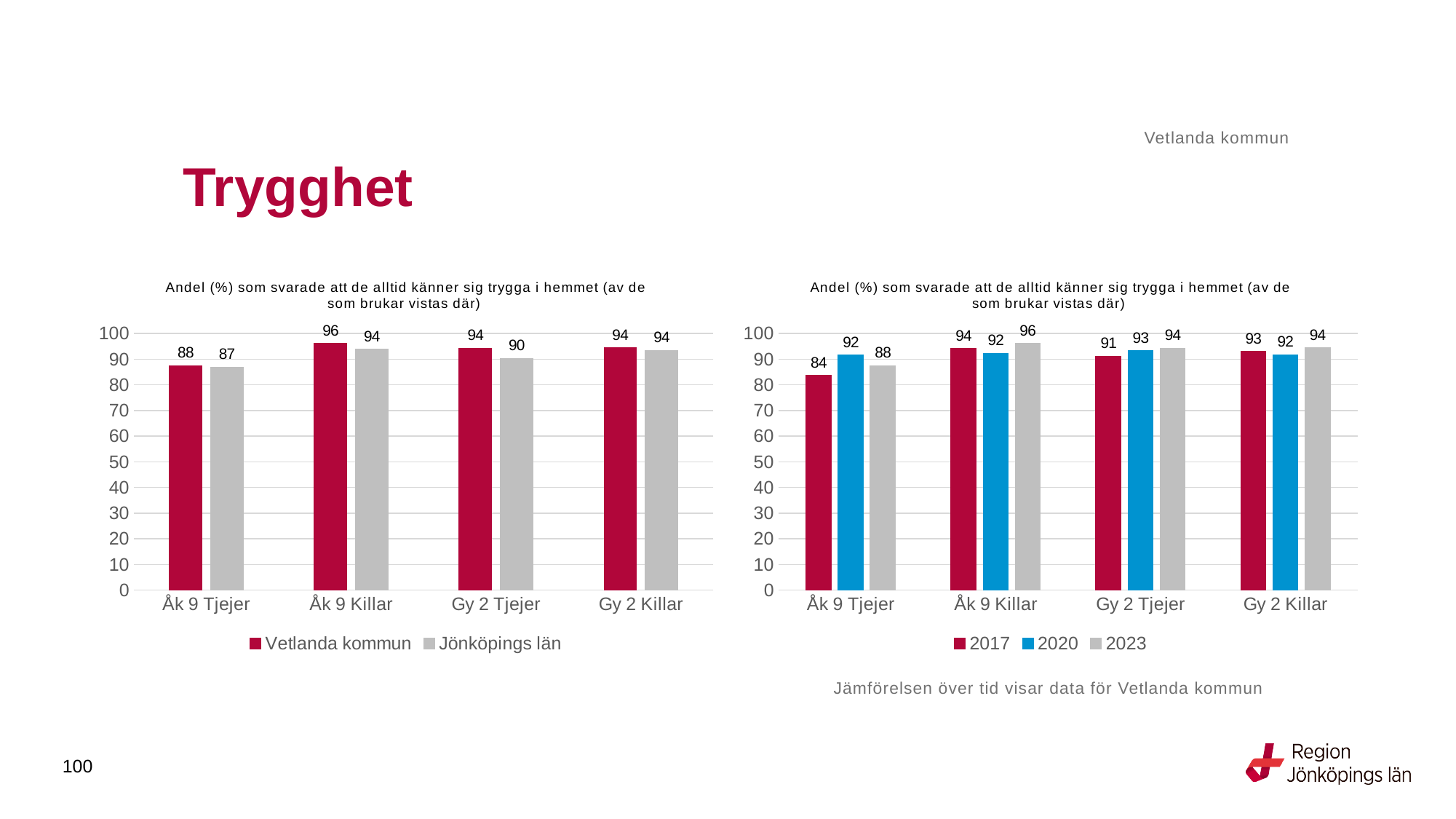
In the left chart, which category has the highest value for Vetlanda kommun? Åk 9 Killar In the left chart, how many series does the legend list? 2 In the left chart, what is the value for Jönköpings län for Gy 2 Tjejer? 90 In the right chart, what is the difference between the 2023 and 2017 values for Åk 9 Tjejer? 4 In the right chart, how many series does the legend list? 3 In the left chart, which category has the lowest value for Jönköpings län? Åk 9 Tjejer In the right chart, what is the value for 2017 for Åk 9 Tjejer? 84 In the left chart, what is the value for Vetlanda kommun for Åk 9 Tjejer? 88 In the right chart, which category has the lowest value for 2017? Åk 9 Tjejer What kind of chart is the right chart? Bar chart In the right chart, what is the value for 2023 for Åk 9 Killar? 96 In the left chart, what is the difference between Vetlanda kommun and Jönköpings län for Gy 2 Tjejer? 4